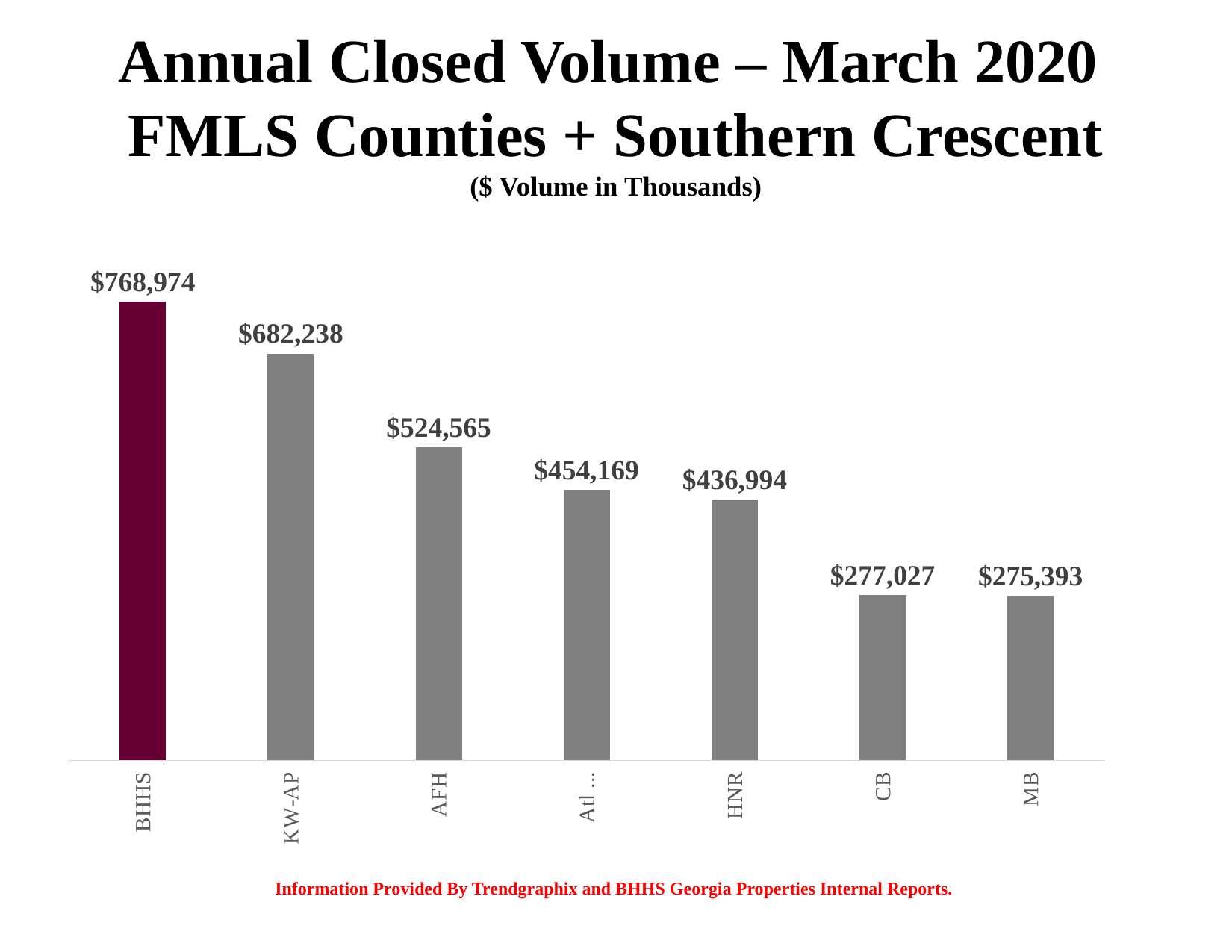
Which category has the lowest annual closed volume? MB What kind of chart is shown on the slide? Bar chart What is the difference between the values for BHHS and KW-AP? $86,736 How many bars are shown in the chart? 7 Which is larger, the value for AFH or the value for HNR? AFH What is the annual closed volume shown for BHHS? $768,974 What is the value shown for KW-AP? $682,238 What is the value shown for HNR? $436,994 What is the value shown for AFH? $524,565 What is the difference between the values for CB and MB? $1,634 What is the value shown for MB? $275,393 Which category has the highest annual closed volume? BHHS